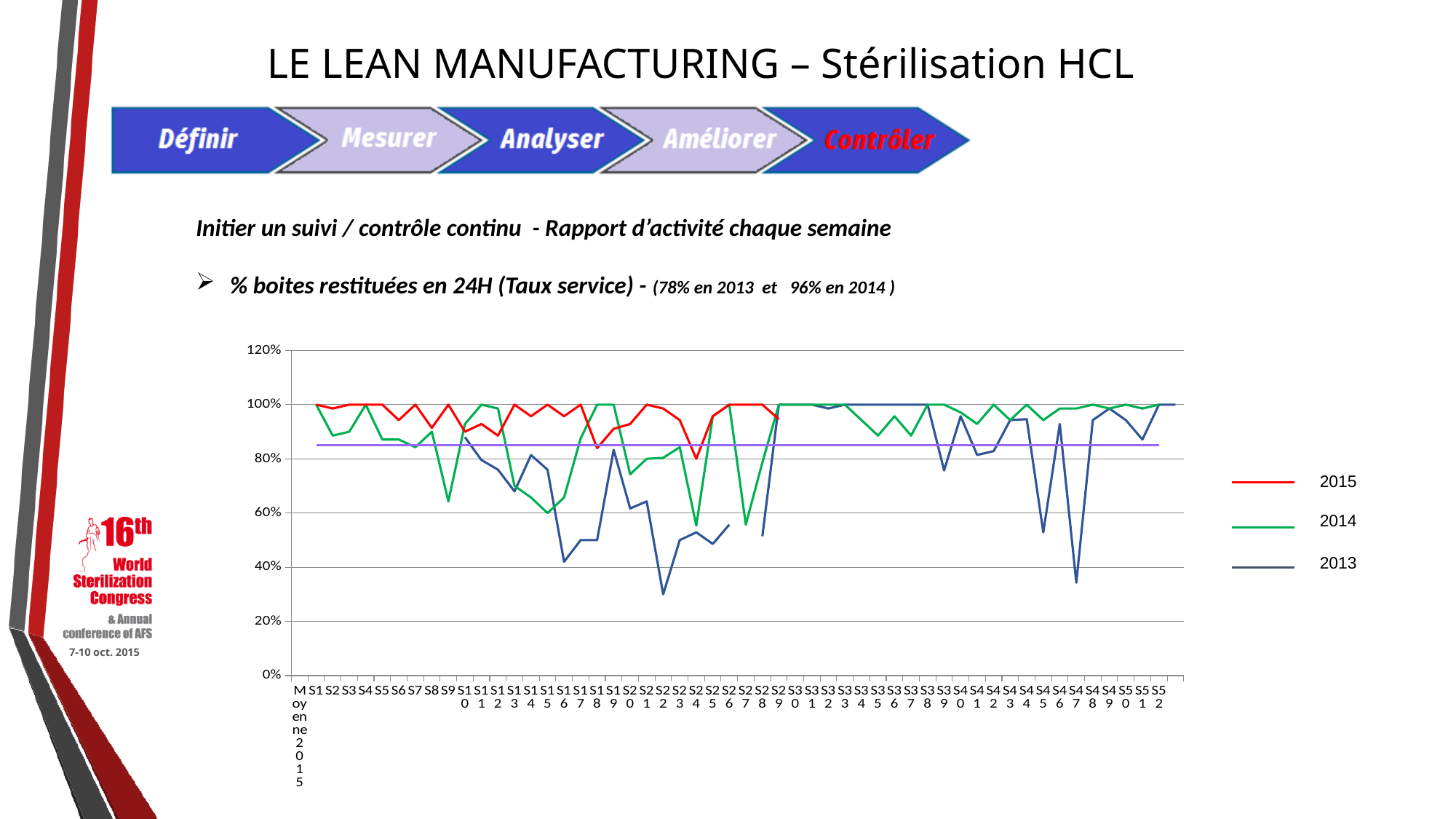
Which series reaches the lowest value anywhere on the chart? 2013 Which years are listed in the chart legend? 2015, 2014, 2013 What colour is the line for the 2014 series? green Is the value for 2013 at S47 greater or less than 40%? less Is the value for 2013 at S12 greater or less than 40%? greater What kind of chart is shown on the slide? line chart Is the value for 2013 at S16 greater or less than 60%? less What is the highest value shown on the vertical axis? 120% How many series does the chart legend list? 3